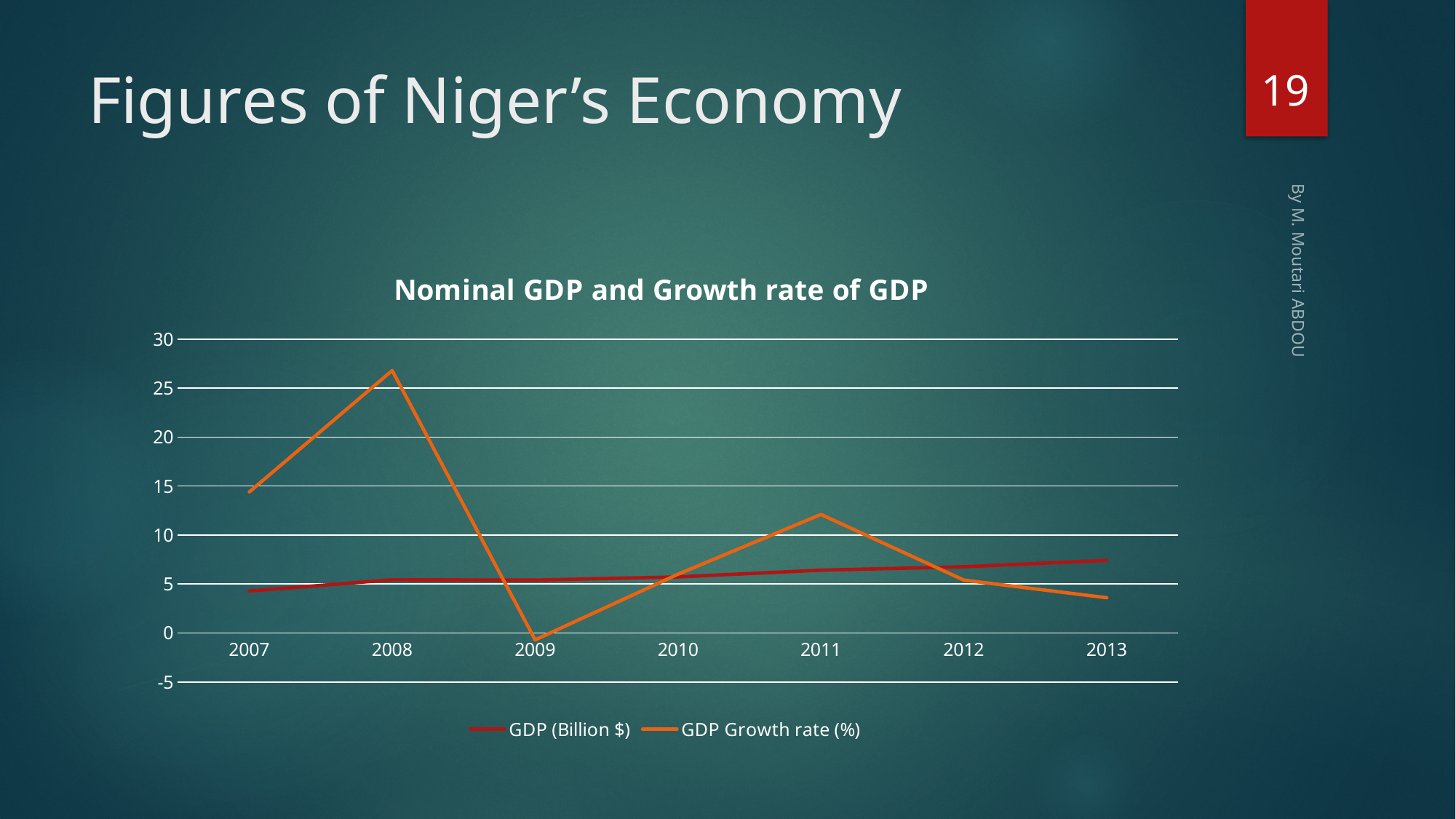
How many years are plotted along the x axis? 7 Is the GDP Growth rate (%) for 2011 greater or less than 10? greater Is the GDP Growth rate (%) for 2008 greater or less than 25? greater Is the GDP (Billion $) value for 2013 greater or less than 5? greater Does the GDP (Billion $) series generally rise or fall from 2007 to 2013? rise Which year has the larger GDP Growth rate (%), 2008 or 2013? 2008 What kind of chart is shown on the slide? line chart In which year is the GDP Growth rate (%) lowest? 2009 In which year is the GDP Growth rate (%) highest? 2008 How many series does the legend list? 2 What is the title of the chart? Nominal GDP and Growth rate of GDP